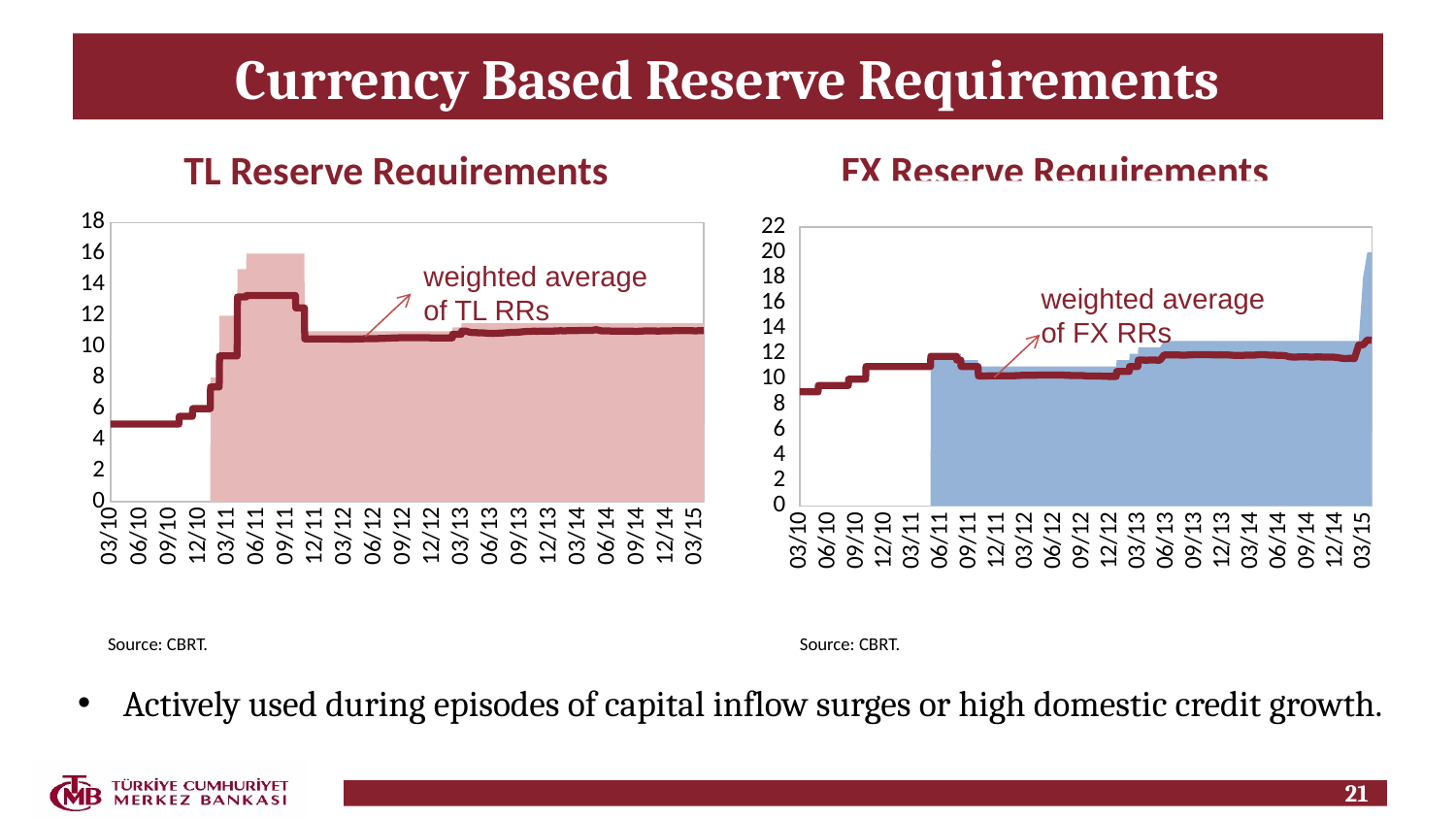
In the TL Reserve Requirements chart, is the weighted average of TL RRs higher at 06/11 or at 03/15? 06/11 In the TL Reserve Requirements chart, does the weighted average of TL RRs rise or fall between 03/10 and 06/11? rise How many date labels are shown on the x axis of the FX Reserve Requirements chart? 21 In the TL Reserve Requirements chart, is the weighted average of TL RRs at 03/15 greater or less than 10? greater In the FX Reserve Requirements chart, is the peak of the shaded area at 03/15 greater or less than 18? greater In the FX Reserve Requirements chart, is the weighted average of FX RRs at 03/10 greater or less than 10? less What is the title of the chart on the right side of the slide? FX Reserve Requirements In the TL Reserve Requirements chart, what does the annotated dark line represent? weighted average of TL RRs What kind of chart is the TL Reserve Requirements chart? line chart with a shaded area In the FX Reserve Requirements chart, is the weighted average of FX RRs higher at 03/10 or at 03/15? 03/15